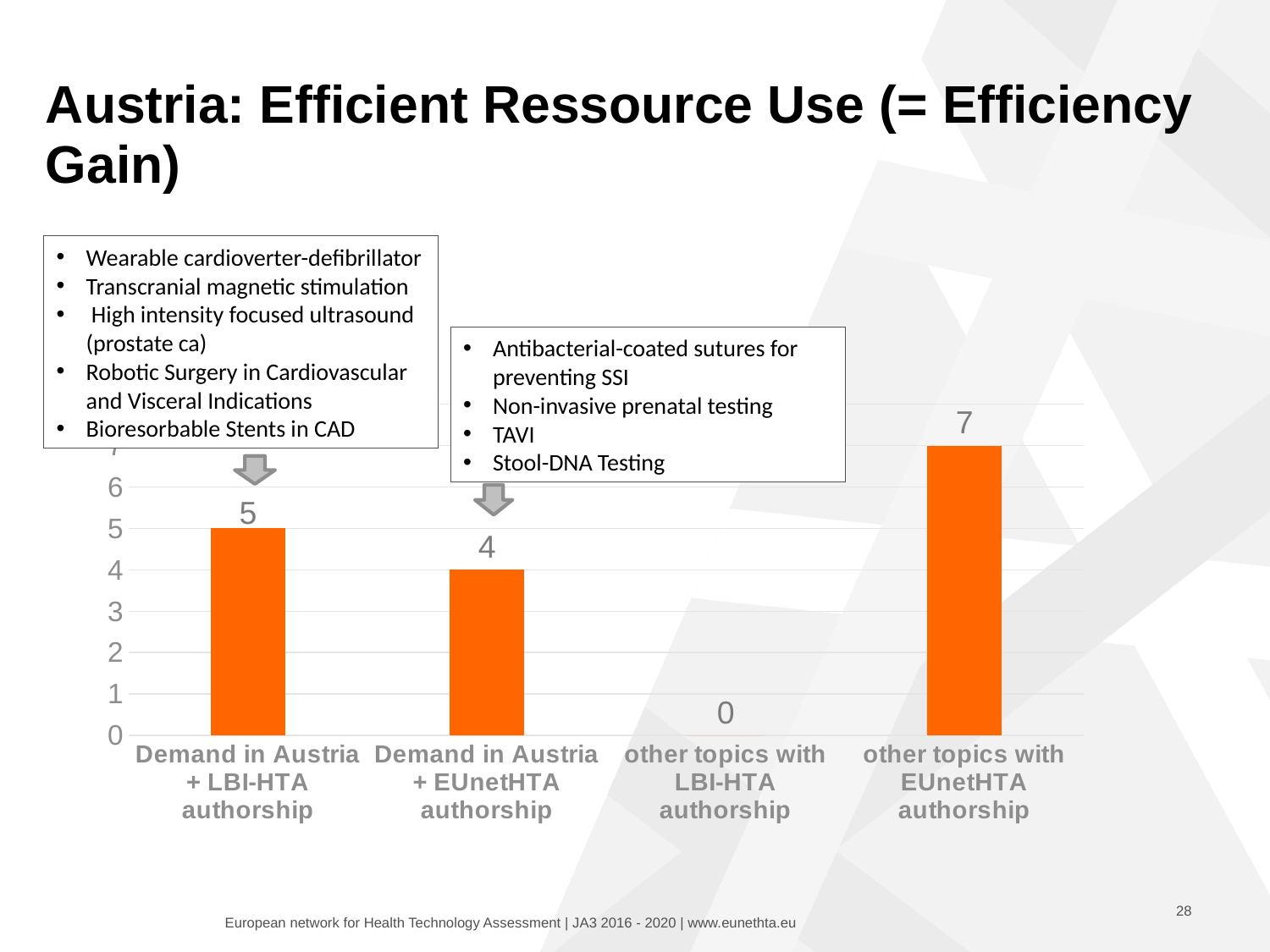
What is the difference between 'other topics with EUnetHTA authorship' and 'Demand in Austria + EUnetHTA authorship'? 3 What kind of chart is shown on the slide? bar chart How many categories are shown on the x axis of the chart? 4 What is the total of the values for the two 'Demand in Austria' categories? 9 What is the value for 'Demand in Austria + EUnetHTA authorship'? 4 What is the value for 'Demand in Austria + LBI-HTA authorship'? 5 What colour are the bars in the chart? orange What is the value for 'other topics with EUnetHTA authorship'? 7 Which category has the highest value? other topics with EUnetHTA authorship Which category has the lowest value? other topics with LBI-HTA authorship Which is larger: 'Demand in Austria + LBI-HTA authorship' or 'Demand in Austria + EUnetHTA authorship'? Demand in Austria + LBI-HTA authorship What is the value for 'other topics with LBI-HTA authorship'? 0